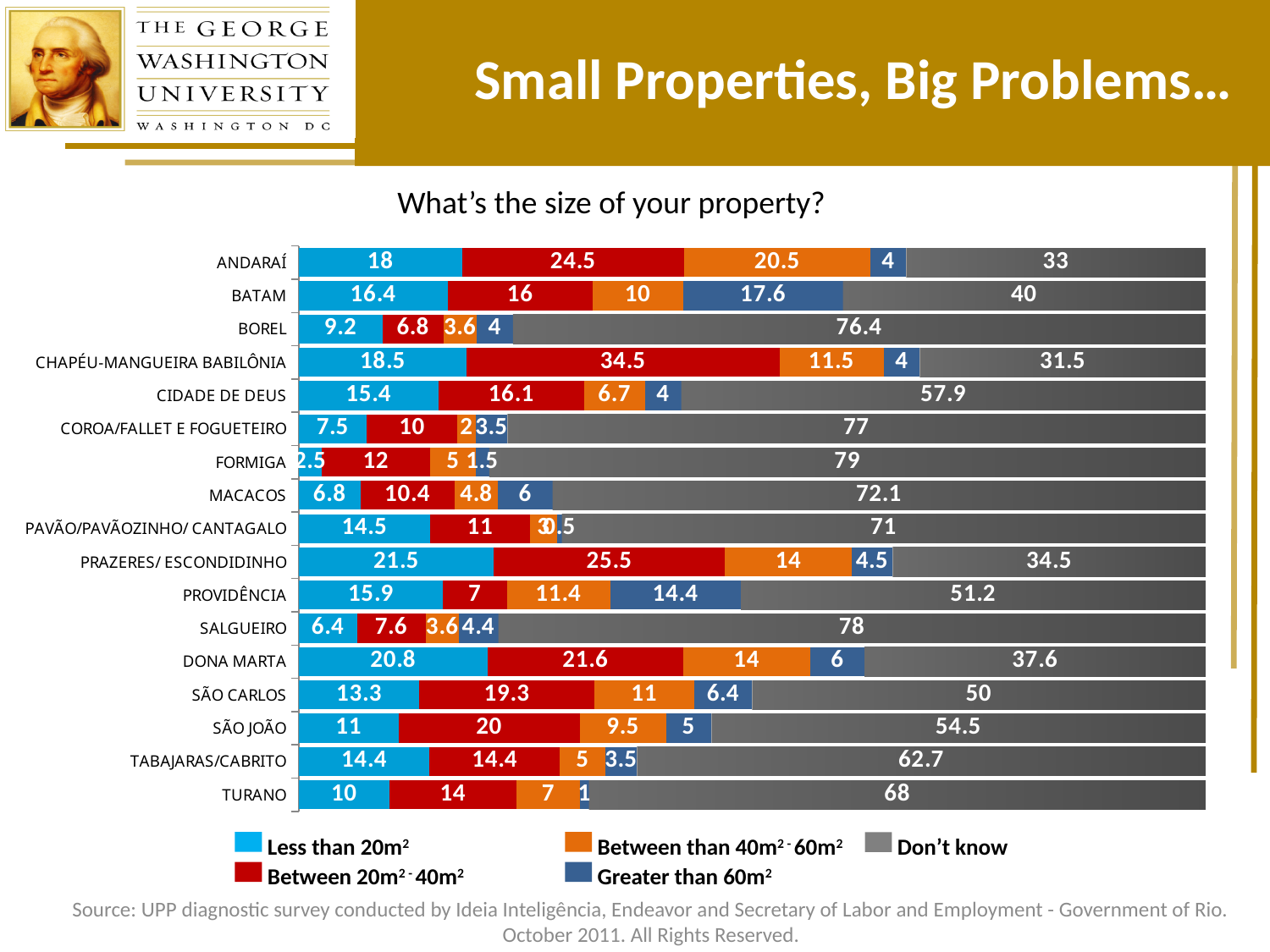
Which is larger for SÃO CARLOS: "Less than 20m²" or "Between 20m² - 40m²"? Between 20m² - 40m² What is the value for "Between 20m² - 40m²" for CHAPÉU-MANGUEIRA BABILÔNIA? 34.5 What is the value for "Greater than 60m²" for PROVIDÊNCIA? 14.4 What is the value for "Don't know" for BATAM? 40 What is the value for "Less than 20m²" for DONA MARTA? 20.8 How many series does the legend list? 5 What is the total of the stacked bar for ANDARAÍ? 100 What kind of chart is shown on the slide? Stacked bar chart Which community has the highest "Don't know" value? FORMIGA Which community has the lowest "Don't know" value? CHAPÉU-MANGUEIRA BABILÔNIA What is the difference between the "Between 20m² - 40m²" and "Less than 20m²" values for ANDARAÍ? 6.5 How many communities are shown in the chart? 17